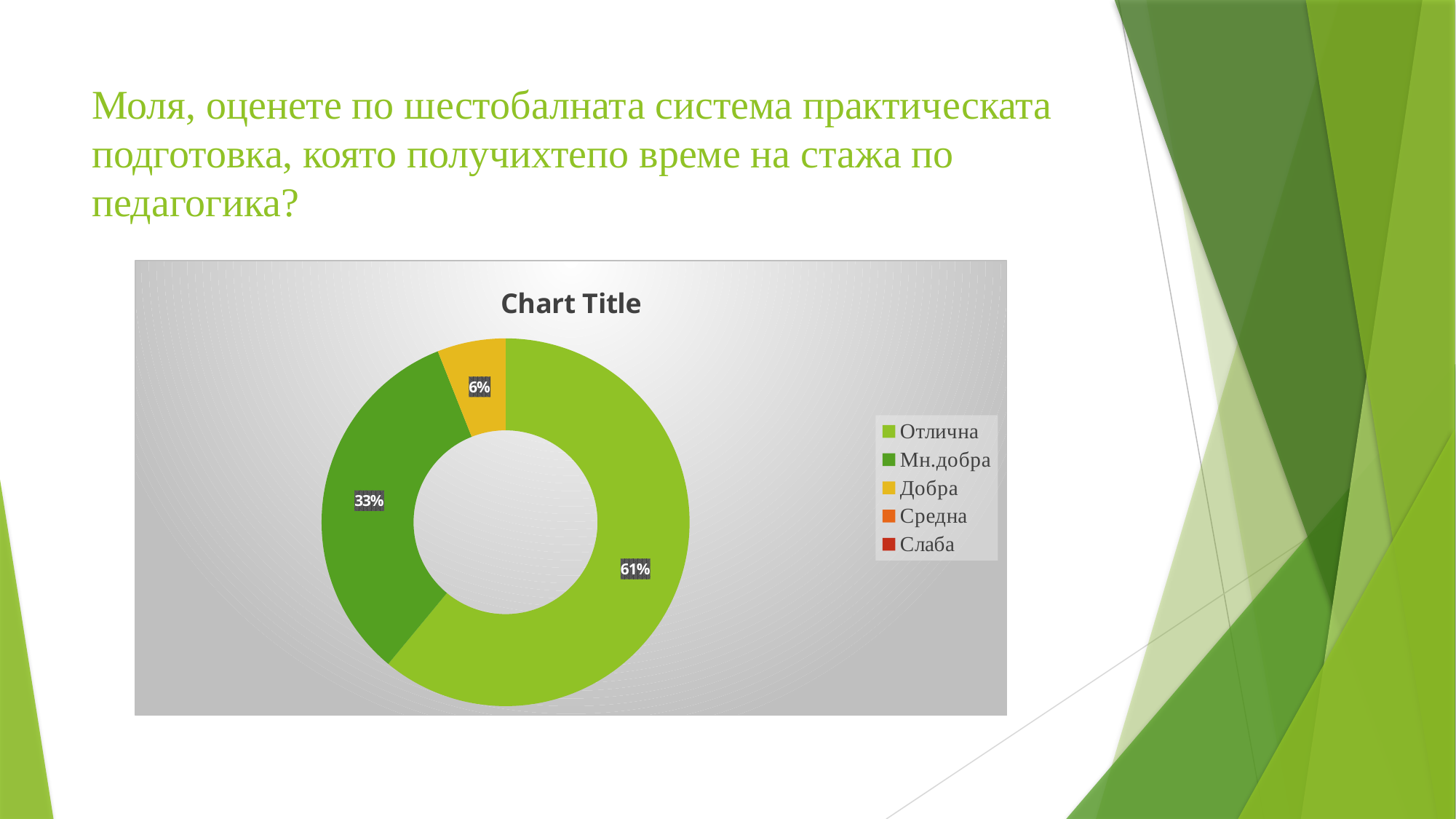
Which of the labelled categories has the smallest share of the chart? Добра What is the difference in percentage points between the Отлична and Мн.добра shares? 28 What share of the doughnut chart is labelled Мн.добра? 33% How many entries does the chart legend list? 5 What is the difference in percentage points between the Мн.добра and Добра shares? 27 What share of the doughnut chart is labelled Добра? 6% Which is larger, the share for Мн.добра or the share for Добра? Мн.добра What share of the doughnut chart is labelled Отлична? 61% What kind of chart is shown on the slide? Doughnut chart What colour is the Добра segment of the chart? Yellow Which category has the largest share of the chart? Отлична What is the title shown above the chart? Chart Title